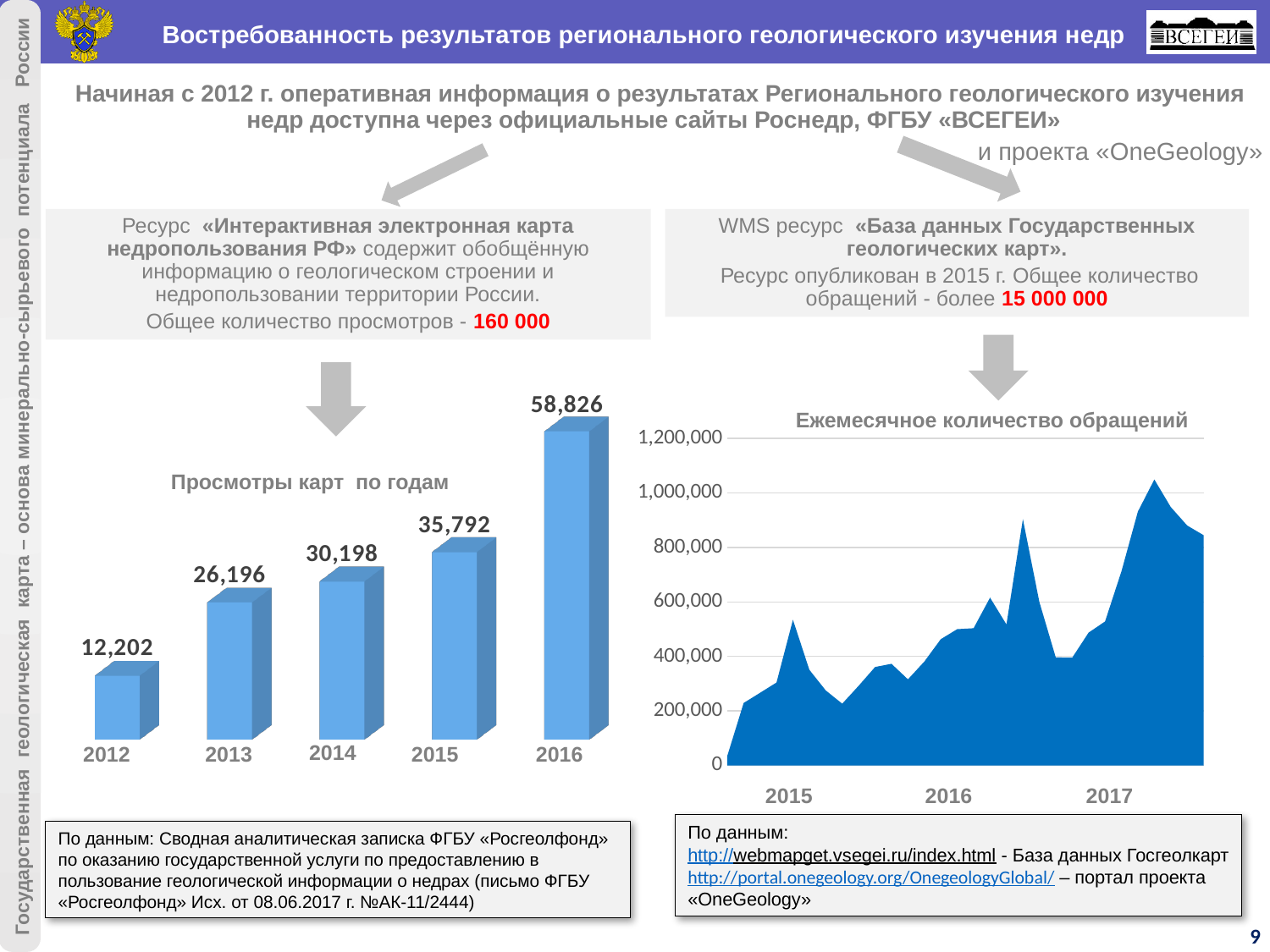
What kind of chart is 'Ежемесячное количество обращений'? area chart In the chart 'Просмотры карт по годам', which year has the lowest value? 2012 In the chart 'Просмотры карт по годам', what is the value for 2016? 58,826 In the chart 'Просмотры карт по годам', what is the difference between the values for 2013 and 2012? 13,994 In the chart 'Просмотры карт по годам', what is the difference between the values for 2016 and 2015? 23,034 What kind of chart is 'Просмотры карт по годам'? bar chart In the chart 'Ежемесячное количество обращений', is the peak value in 2017 greater or less than 1,000,000? greater In the chart 'Просмотры карт по годам', how many years are shown? 5 In the chart 'Просмотры карт по годам', what is the value for 2014? 30,198 In the chart 'Просмотры карт по годам', which year has the highest value? 2016 In the chart 'Просмотры карт по годам', what is the value for 2012? 12,202 In the chart 'Просмотры карт по годам', do the values rise or fall from 2012 to 2016? rise